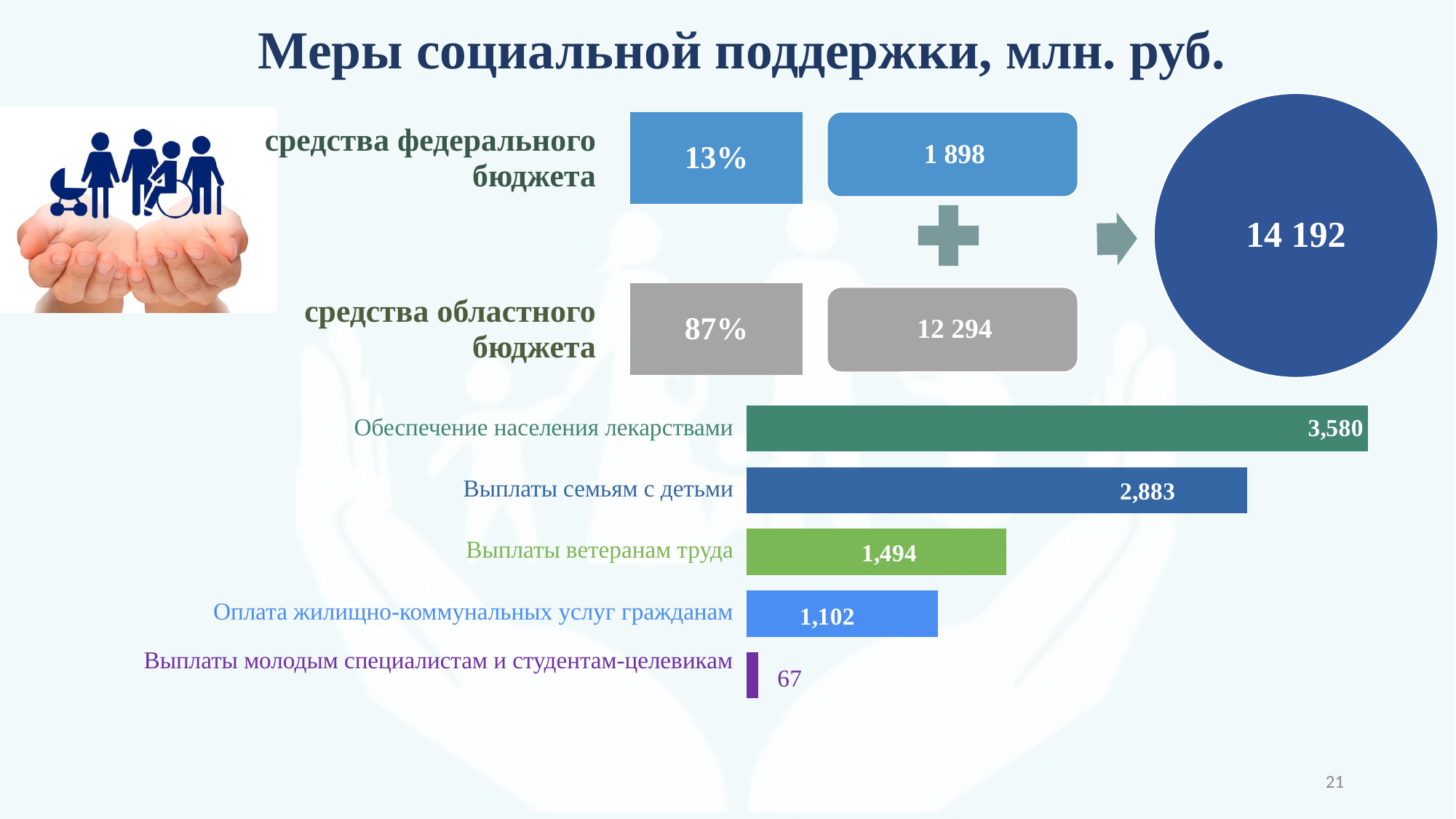
What is the difference between the values for "Обеспечение населения лекарствами" and "Выплаты семьям с детьми"? 697 Which is larger in the bar chart: "Выплаты ветеранам труда" or "Оплата жилищно-коммунальных услуг гражданам"? Выплаты ветеранам труда Which category has the lowest value in the bar chart? Выплаты молодым специалистам и студентам-целевикам What is the value for "Выплаты молодым специалистам и студентам-целевикам" in the bar chart? 67 What is the value for "Оплата жилищно-коммунальных услуг гражданам" in the bar chart? 1,102 What is the value for "Обеспечение населения лекарствами" in the bar chart? 3,580 What is the value for "Выплаты семьям с детьми" in the bar chart? 2,883 What is the value for "Выплаты ветеранам труда" in the bar chart? 1,494 What type of chart is shown in the lower part of the slide? bar chart What is the title of the slide containing the bar chart? Меры социальной поддержки, млн. руб. Which category has the highest value in the bar chart? Обеспечение населения лекарствами How many categories does the bar chart show? 5